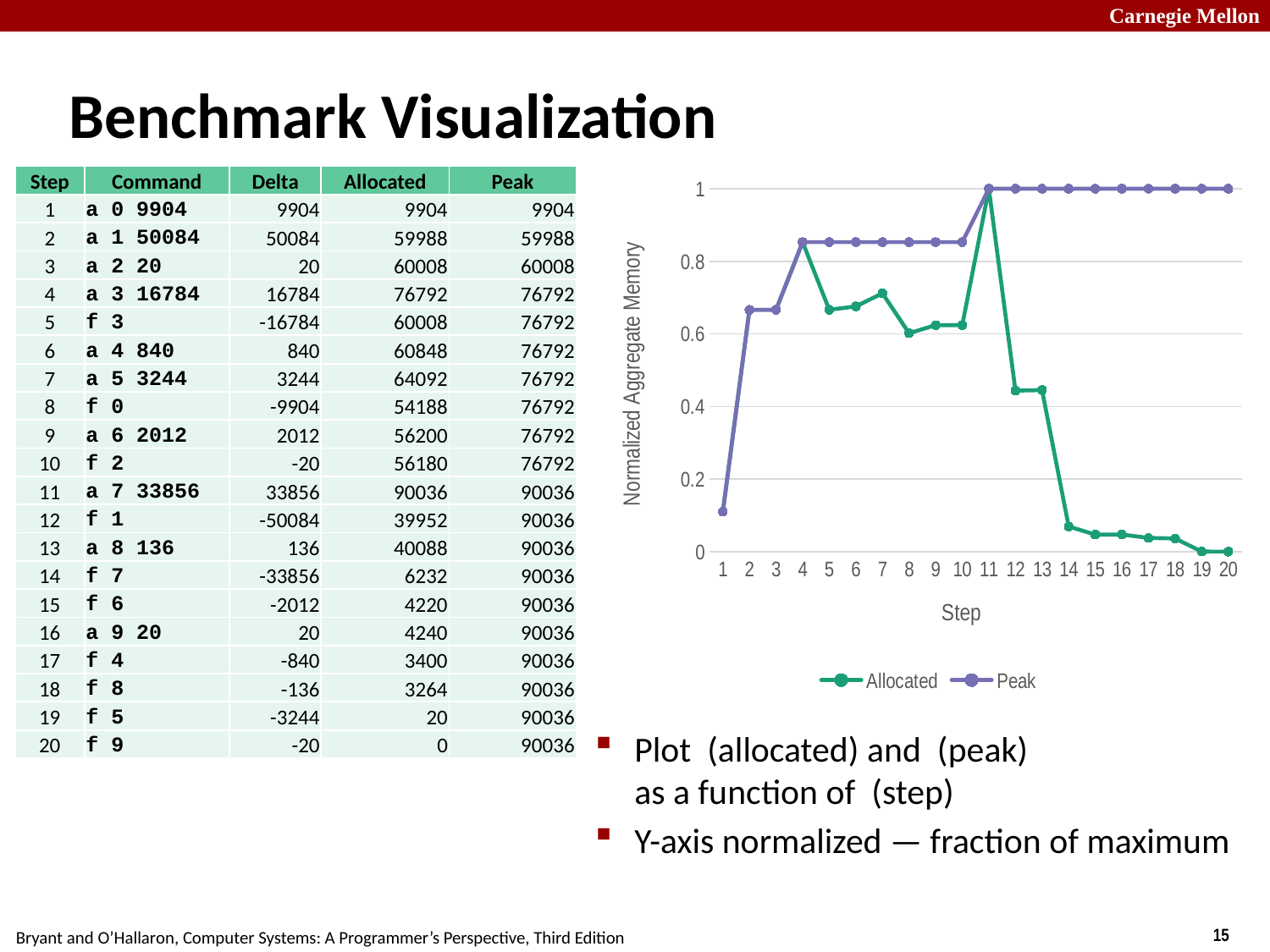
Is the Allocated value at step 8 greater or less than 0.8? less What is the value of the Allocated series at step 20? 0 How many steps are plotted along the x axis of the chart? 20 What is the label of the y axis of the chart? Normalized Aggregate Memory What kind of chart is shown on the slide? line chart Does the Peak series rise or fall from step 1 to step 11? rise Is the Peak value at step 5 greater or less than 0.8? greater How many series does the chart legend list? 2 What is the value of the Peak series at step 20? 1 Is the Allocated value at step 12 greater or less than 0.6? less What are the two series named in the chart legend? Allocated and Peak At step 14, which series has the larger value, Allocated or Peak? Peak